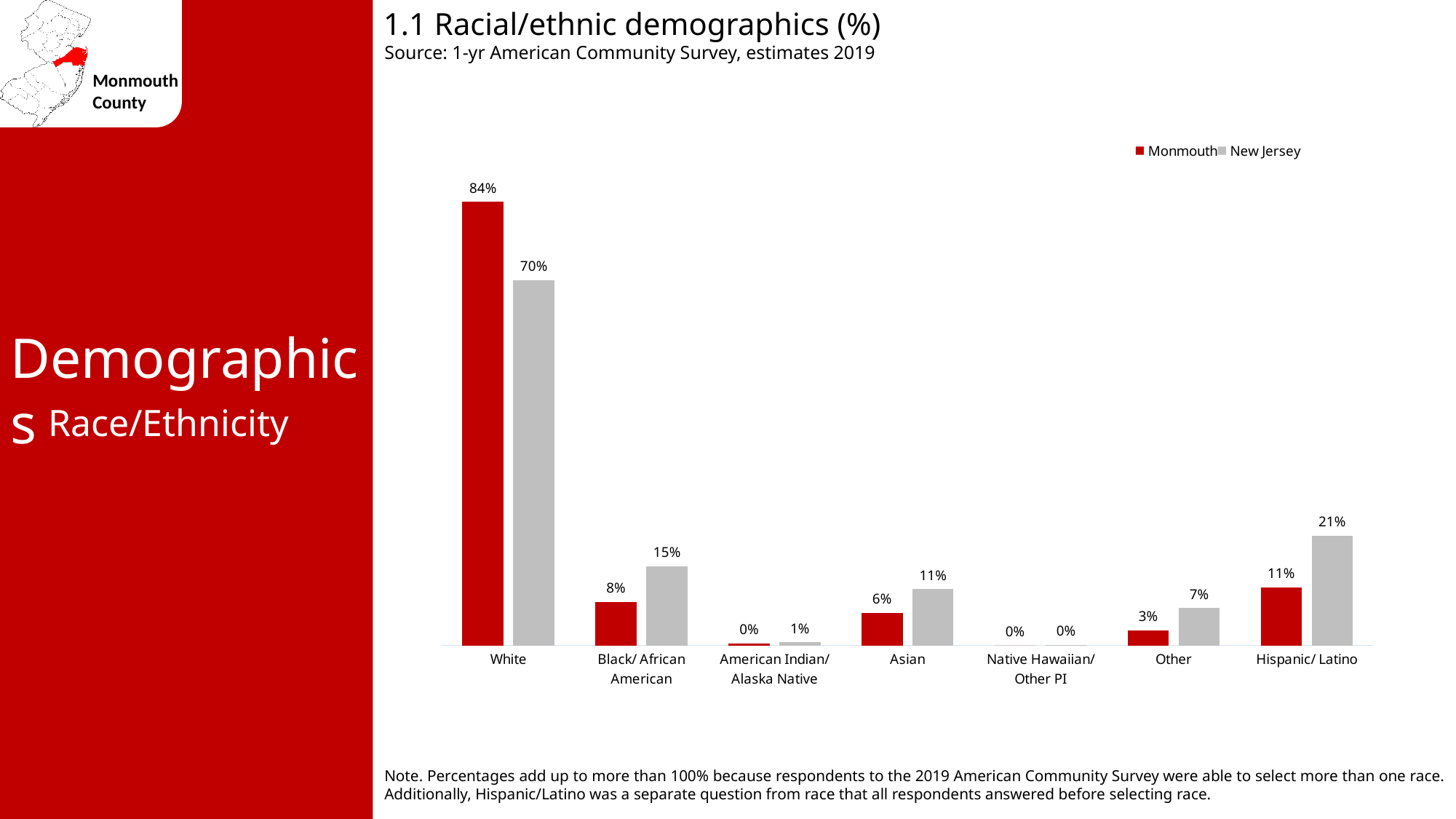
What is the difference between the Monmouth and New Jersey values for White? 14% What kind of chart is shown on the slide? Bar chart How many series does the legend list? 2 What is the New Jersey value for Hispanic/ Latino? 21% Which is larger for Other: the Monmouth value or the New Jersey value? New Jersey How many categories are shown on the x axis? 7 What is the New Jersey value for Black/ African American? 15% What is the title of the chart? 1.1 Racial/ethnic demographics (%) What is the difference between the New Jersey and Monmouth values for Hispanic/ Latino? 10% Which category has the highest Monmouth value? White What is the Monmouth value for Asian? 6% What is the Monmouth value for White? 84%